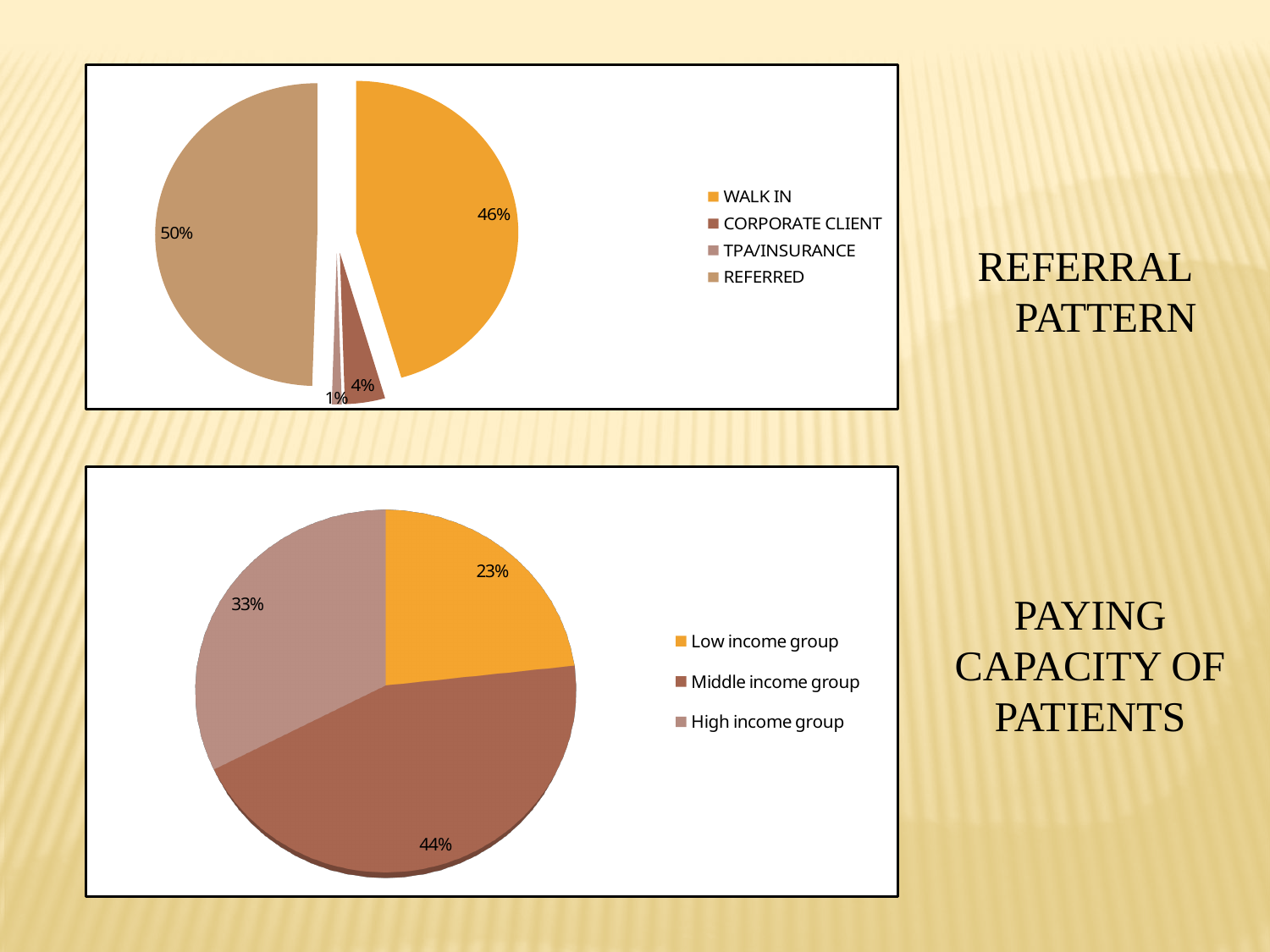
In the bottom chart (Paying Capacity of Patients), which is larger: the High income group or the Low income group? High income group In the bottom chart (Paying Capacity of Patients), what share is the Middle income group? 44% In the top chart (Referral Pattern), what share of patients are REFERRED? 50% In the top chart (Referral Pattern), what is the difference between the REFERRED and WALK IN shares? 4% What kind of chart is the bottom chart (Paying Capacity of Patients)? Pie chart In the top chart (Referral Pattern), how many categories does the legend list? 4 In the bottom chart (Paying Capacity of Patients), what is the difference between the Middle income group and High income group shares? 11% In the bottom chart (Paying Capacity of Patients), which group has the smallest share? Low income group In the top chart (Referral Pattern), which category has the smallest share? TPA/INSURANCE In the top chart (Referral Pattern), what share of patients are WALK IN? 46% In the top chart (Referral Pattern), which category has the largest share? REFERRED In the top chart (Referral Pattern), what share of patients are CORPORATE CLIENT? 4%